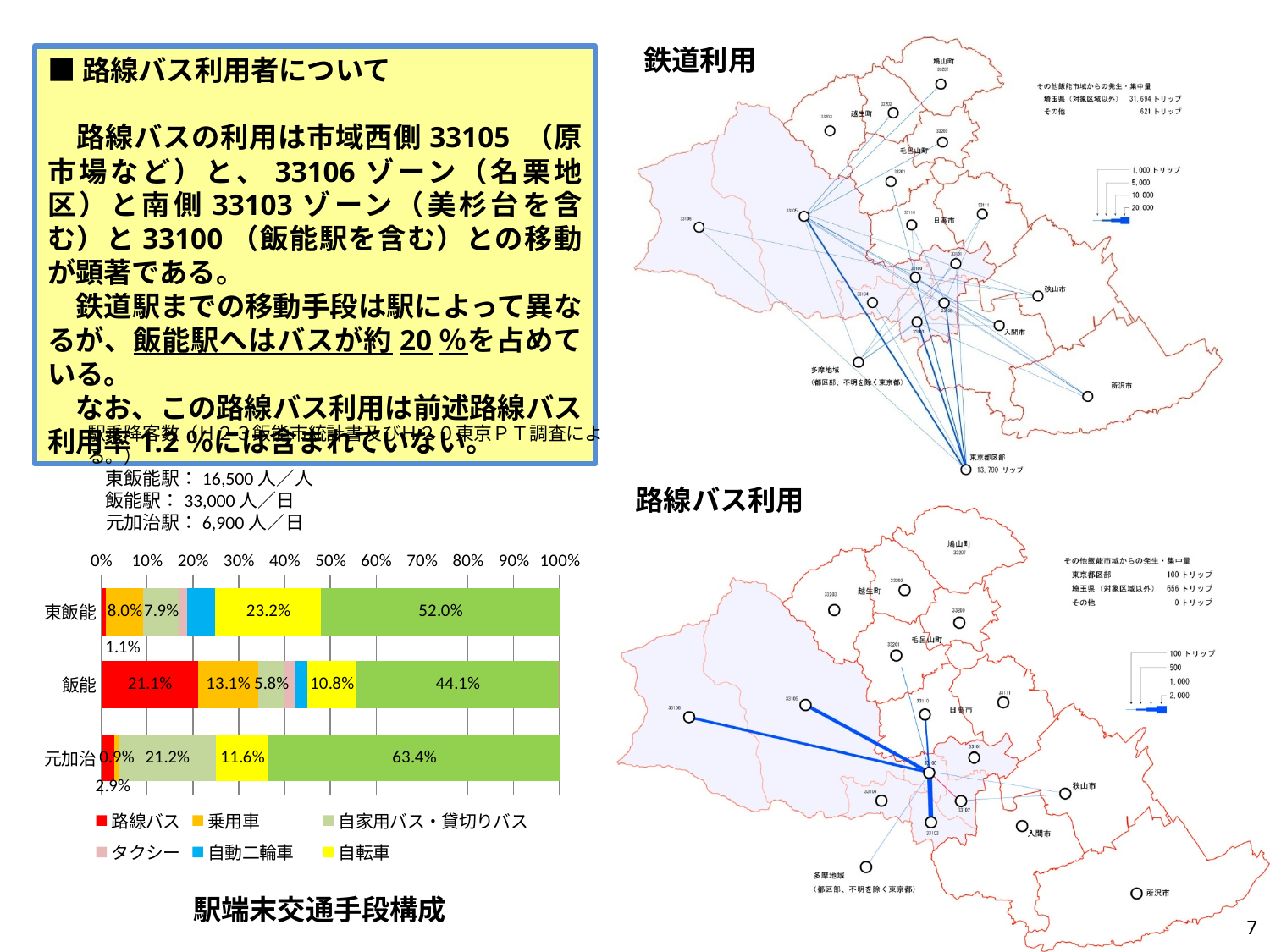
In the 駅端末交通手段構成 chart, what is the 自家用バス・貸切りバス share for 元加治? 21.2% How many series does the legend of the 駅端末交通手段構成 chart list? 6 What kind of chart is 駅端末交通手段構成? Stacked bar chart In the 駅端末交通手段構成 chart, which is larger, the 自転車 share for 東飯能 or for 飯能? 東飯能 In the 駅端末交通手段構成 chart, which station has the highest 路線バス share? 飯能 In the 駅端末交通手段構成 chart, what is the 自転車 share for 東飯能? 23.2% How many stations (categories) are shown in the 駅端末交通手段構成 chart? 3 In the 駅端末交通手段構成 chart, which station has the highest 自家用バス・貸切りバス share? 元加治 In the 駅端末交通手段構成 chart, what is the 路線バス share for 飯能? 21.1% In the 駅端末交通手段構成 chart, what is the difference between the 自転車 share for 東飯能 and for 飯能? 12.4 percentage points In the 駅端末交通手段構成 chart, what is the 自転車 share for 元加治? 11.6% In the 駅端末交通手段構成 chart, what is the 乗用車 share for 飯能? 13.1%